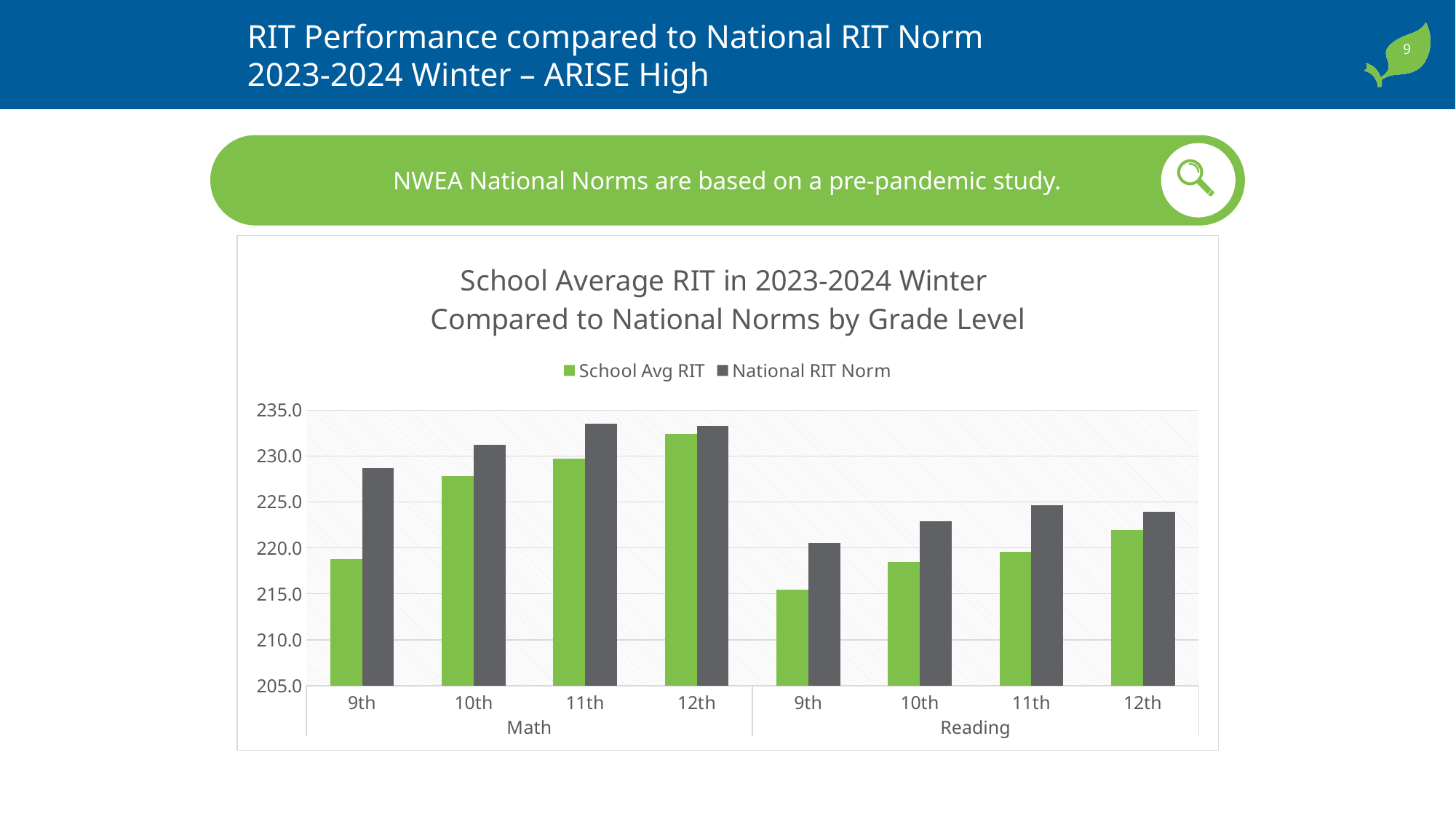
How many grade-level categories are plotted along the x axis? 8 Is the National RIT Norm for 11th grade Math greater or less than 230.0? greater What colour are the School Avg RIT bars? Green What kind of chart is shown on the slide? Bar chart Which grade level and subject has the lowest School Avg RIT? 9th Reading For 10th grade Math, which is larger: the School Avg RIT or the National RIT Norm? National RIT Norm Is the School Avg RIT for 12th grade Reading greater or less than 220.0? greater How many series does the legend list? 2 Which grade level and subject has the highest School Avg RIT? 12th Math Is the School Avg RIT for 9th grade Math greater or less than 220.0? less Which grade level and subject has the lowest National RIT Norm? 9th Reading Does the School Avg RIT rise or fall from 9th to 12th grade in Math? Rises